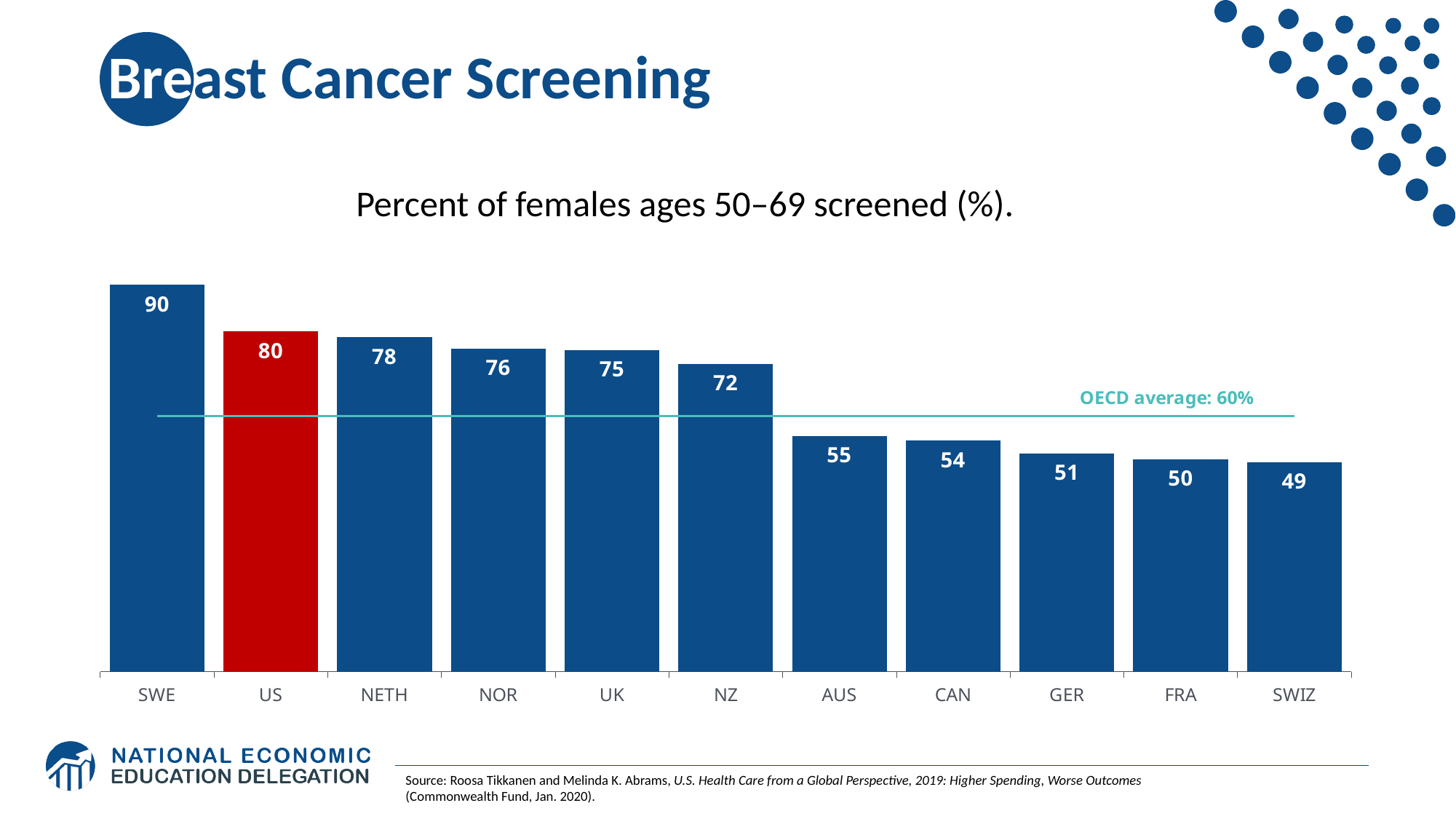
What kind of chart is this? Bar chart What OECD average is marked by the horizontal line on the chart? 60% How many countries are shown on the chart? 11 What is the value for NZ? 72 Which country has the lowest value? SWIZ What is the value for the US? 80 Which country has the highest value? SWE What is the value for FRA? 50 Which is larger, the value for NOR or the value for CAN? NOR What is the difference between the values for SWE and the US? 10 What is the difference between the values for NETH and AUS? 23 Do the values rise or fall from left to right along the x axis? Fall